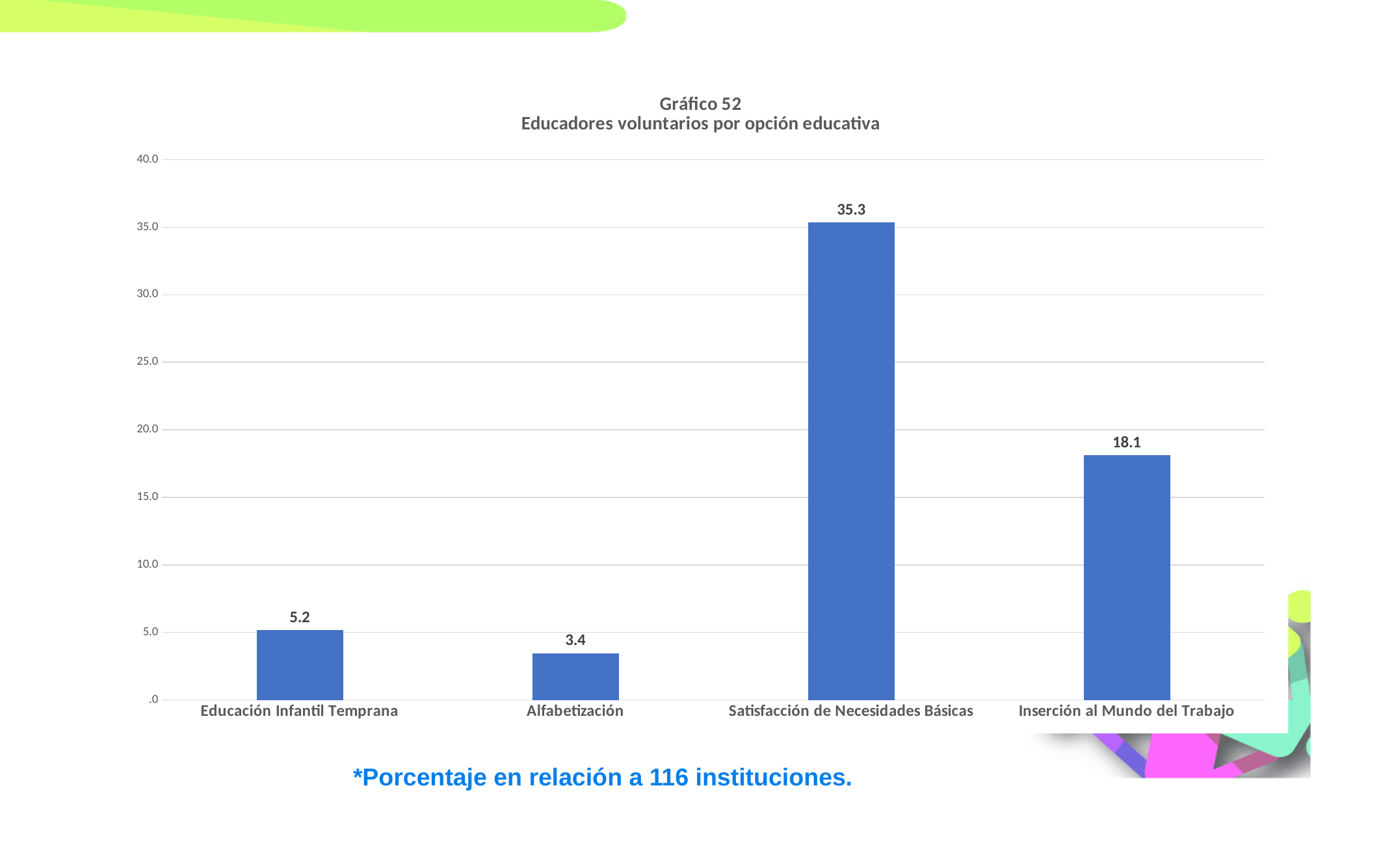
What is the value for Educación Infantil Temprana? 5.2 What is the value for Inserción al Mundo del Trabajo? 18.1 What is the value for Satisfacción de Necesidades Básicas? 35.3 What is the title of the chart? Gráfico 52 Educadores voluntarios por opción educativa What is the difference between the values for Satisfacción de Necesidades Básicas and Inserción al Mundo del Trabajo? 17.2 Which is larger, the value for Inserción al Mundo del Trabajo or the value for Educación Infantil Temprana? Inserción al Mundo del Trabajo What is the value for Alfabetización? 3.4 What kind of chart is shown on the slide? Bar chart What is the difference between the values for Educación Infantil Temprana and Alfabetización? 1.8 Which category has the highest value? Satisfacción de Necesidades Básicas How many categories are shown on the x axis? 4 Which category has the lowest value? Alfabetización